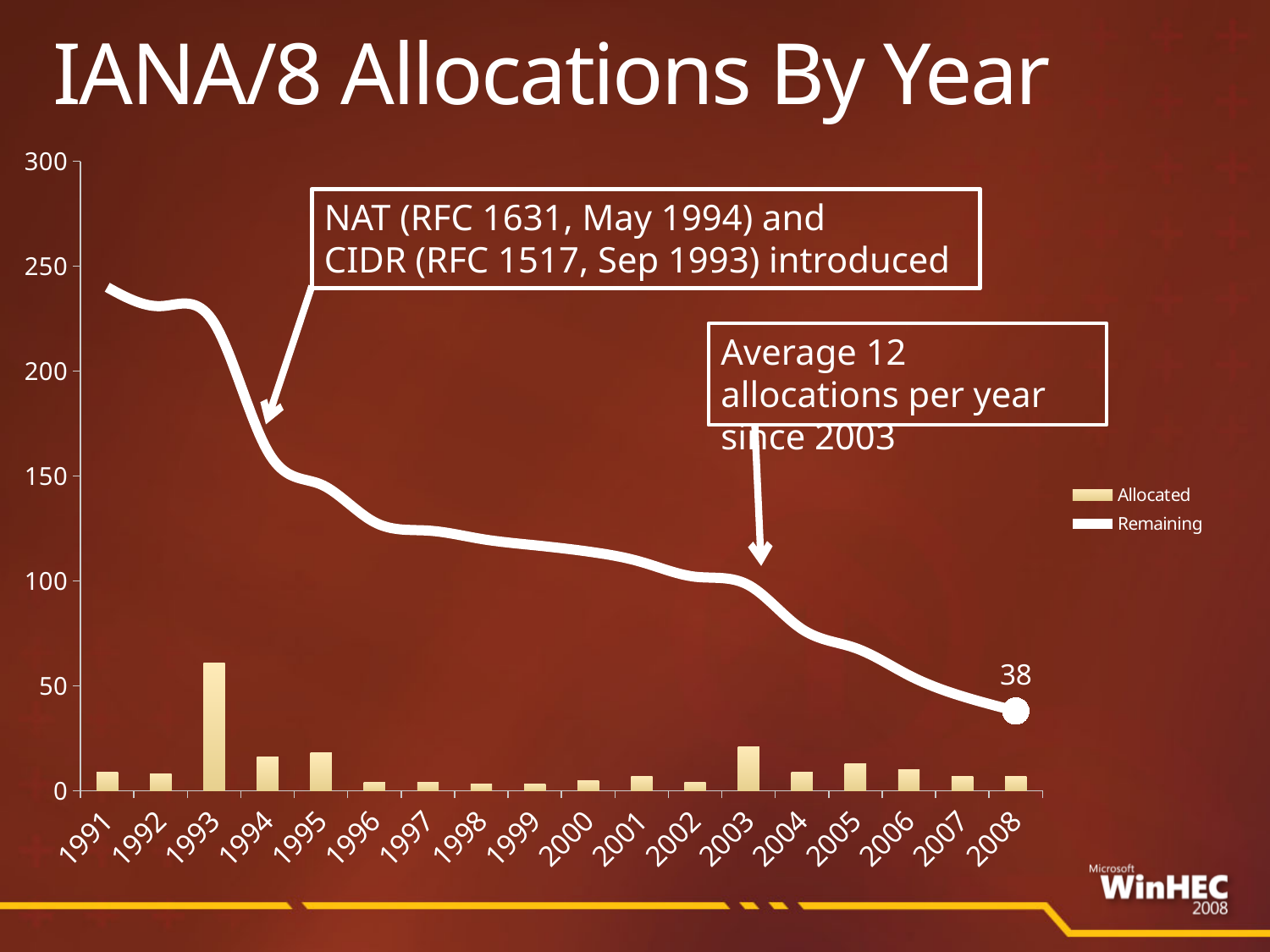
Is the Remaining value for 1991 greater or less than 200? greater Does the Remaining line rise or fall from 1991 to 2008? Fall How many years are shown on the x axis? 18 In which year is the Allocated value highest? 1993 What is the Remaining value for 2008? 38 What is the title of the chart? IANA/8 Allocations By Year Is the Remaining value for 2004 greater or less than 100? less Which is larger, the Allocated value for 1993 or for 2003? 1993 Which series is drawn as a line rather than bars? Remaining Is the Allocated value for 1993 greater or less than 50? greater What kind of chart is this? Combined bar and line chart How many series does the legend list? 2